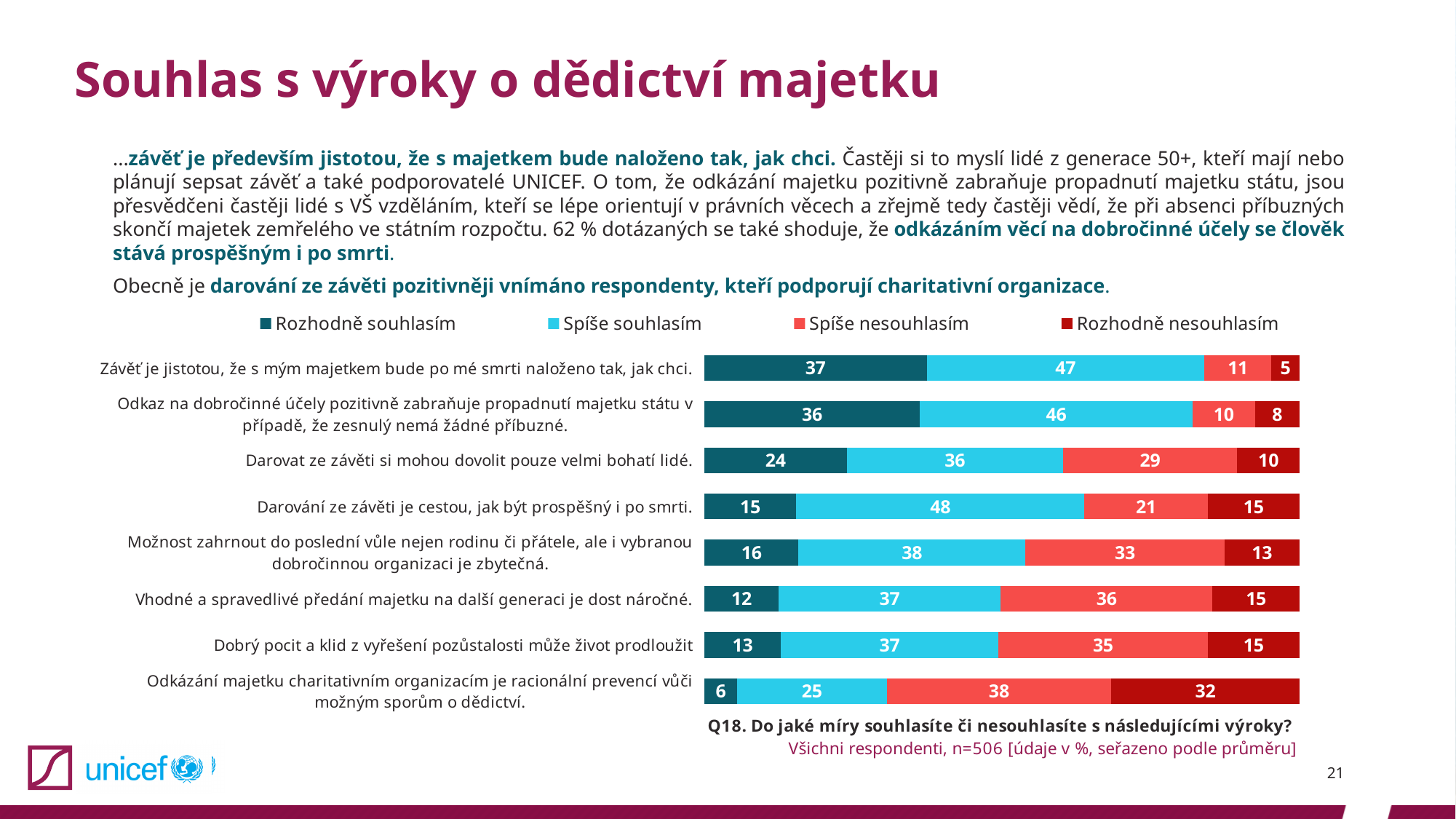
How many statements (categories) are plotted in the chart? 8 What is the value of "Spíše souhlasím" for "Darování ze závěti je cestou, jak být prospěšný i po smrti."? 48 What is the difference between the "Spíše nesouhlasím" values for "Vhodné a spravedlivé předání majetku na další generaci je dost náročné." and "Závěť je jistotou, že s mým majetkem bude po mé smrti naloženo tak, jak chci."? 25 What kind of chart is shown on the slide? Stacked bar chart Which is larger: the "Rozhodně nesouhlasím" value for "Darovat ze závěti si mohou dovolit pouze velmi bohatí lidé." or for "Možnost zahrnout do poslední vůle nejen rodinu či přátele, ale i vybranou dobročinnou organizaci je zbytečná."? Možnost zahrnout do poslední vůle nejen rodinu či přátele, ale i vybranou dobročinnou organizaci je zbytečná. What is the value of "Rozhodně nesouhlasím" for "Odkázání majetku charitativním organizacím je racionální prevencí vůči možným sporům o dědictví."? 32 Which statement has the highest value for "Rozhodně souhlasím"? Závěť je jistotou, že s mým majetkem bude po mé smrti naloženo tak, jak chci. How many series does the legend list? 4 Which statement has the lowest value for "Spíše souhlasím"? Odkázání majetku charitativním organizacím je racionální prevencí vůči možným sporům o dědictví. What is the value of "Rozhodně souhlasím" for "Darovat ze závěti si mohou dovolit pouze velmi bohatí lidé."? 24 Which legend entry is shown in the darkest red colour? Rozhodně nesouhlasím What is the combined value of "Rozhodně souhlasím" and "Spíše souhlasím" for "Odkaz na dobročinné účely pozitivně zabraňuje propadnutí majetku státu v případě, že zesnulý nemá žádné příbuzné."? 82